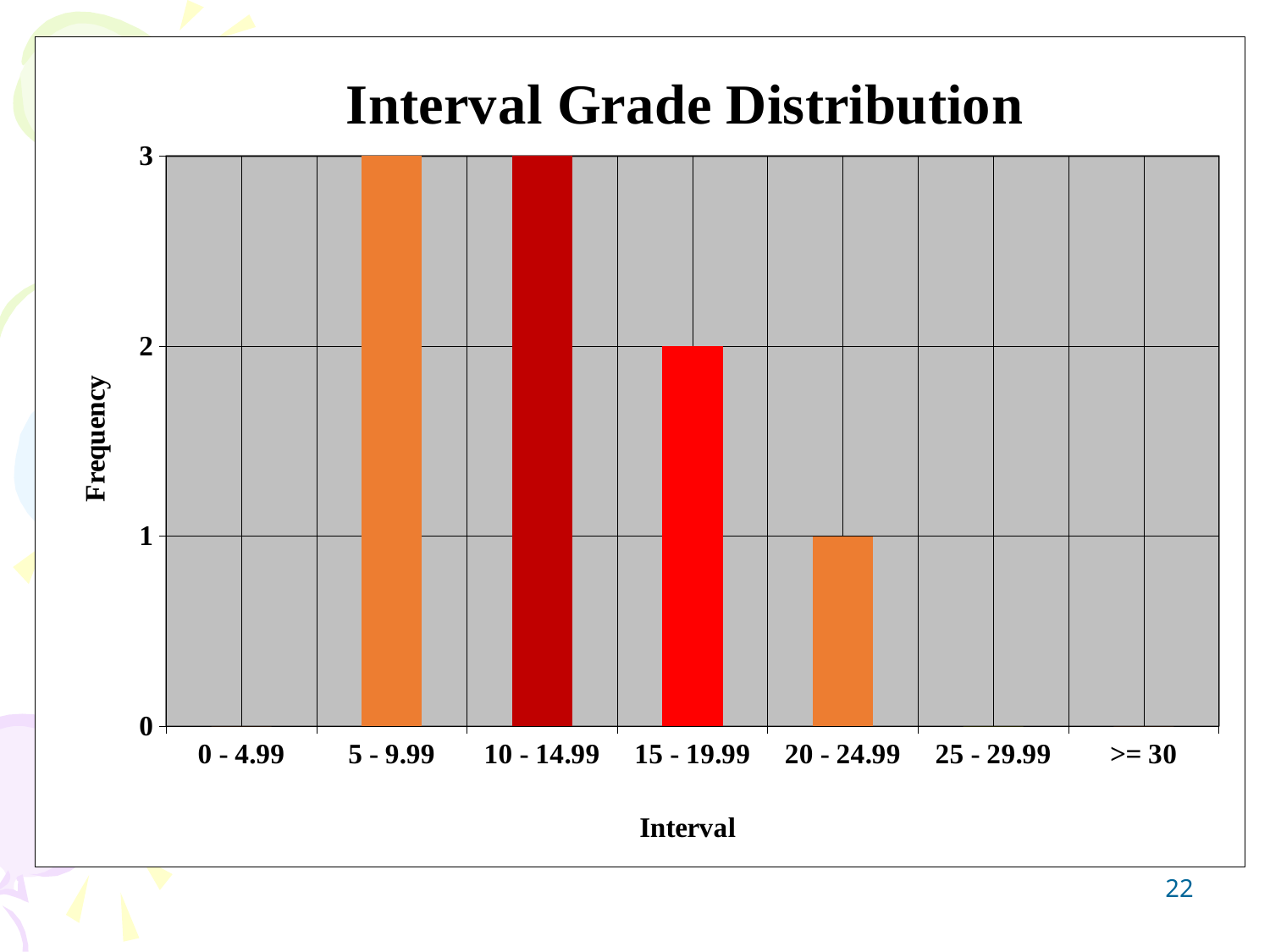
What is the label of the y axis? Frequency What is the difference in frequency between the 5 - 9.99 interval and the 20 - 24.99 interval? 2 What type of chart is shown on the slide? bar chart What is the frequency for the 15 - 19.99 interval? 2 Do the frequencies rise or fall from the 10 - 14.99 interval to the 20 - 24.99 interval? fall How many intervals are shown on the x axis? 7 What is the title of the chart? Interval Grade Distribution What is the frequency for the 20 - 24.99 interval? 1 Which has the higher frequency, the 10 - 14.99 interval or the 15 - 19.99 interval? 10 - 14.99 What is the frequency for the 5 - 9.99 interval? 3 Which has the higher frequency, the 20 - 24.99 interval or the 15 - 19.99 interval? 15 - 19.99 What is the frequency for the 10 - 14.99 interval? 3